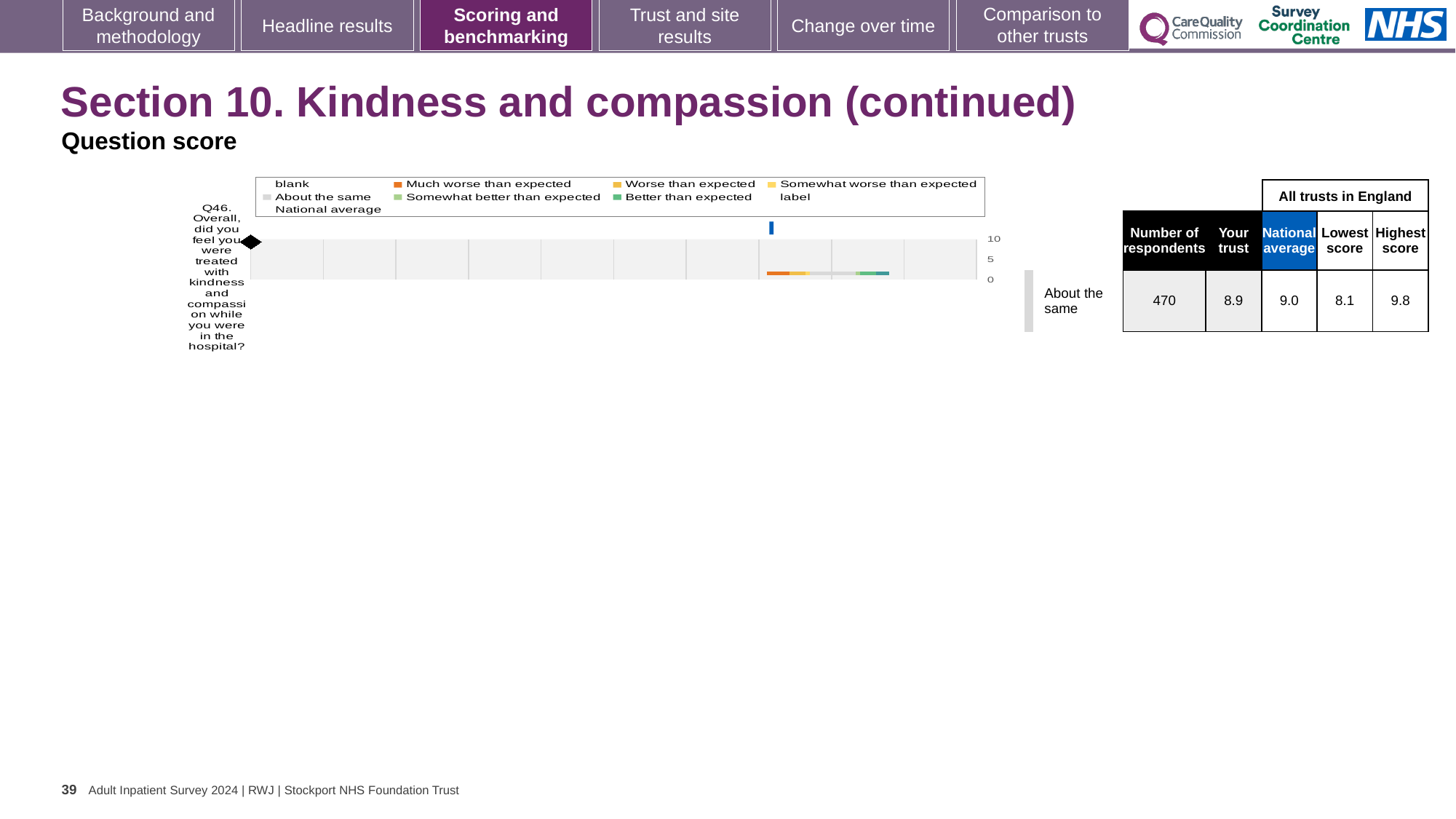
What is the Highest score among all trusts in England for Q46? 9.8 How many respondents answered Q46? 470 Which survey question does the chart on the slide relate to? Q46. Overall, did you feel you were treated with kindness and compassion while you were in the hospital? What is the Lowest score among all trusts in England for Q46? 8.1 What is the difference between the National average and the Your trust score for Q46? 0.1 What is the difference between the Highest score and the Lowest score for Q46? 1.7 What is the score for Your trust on Q46? 8.9 Which is larger for Q46, the Your trust score or the National average? National average What type of chart is shown on the slide? bar chart What is the National average score for Q46? 9.0 Is the Your trust score for Q46 greater or less than 5 on the chart axis? greater Which benchmarking category is the trust's result for Q46 placed in? About the same